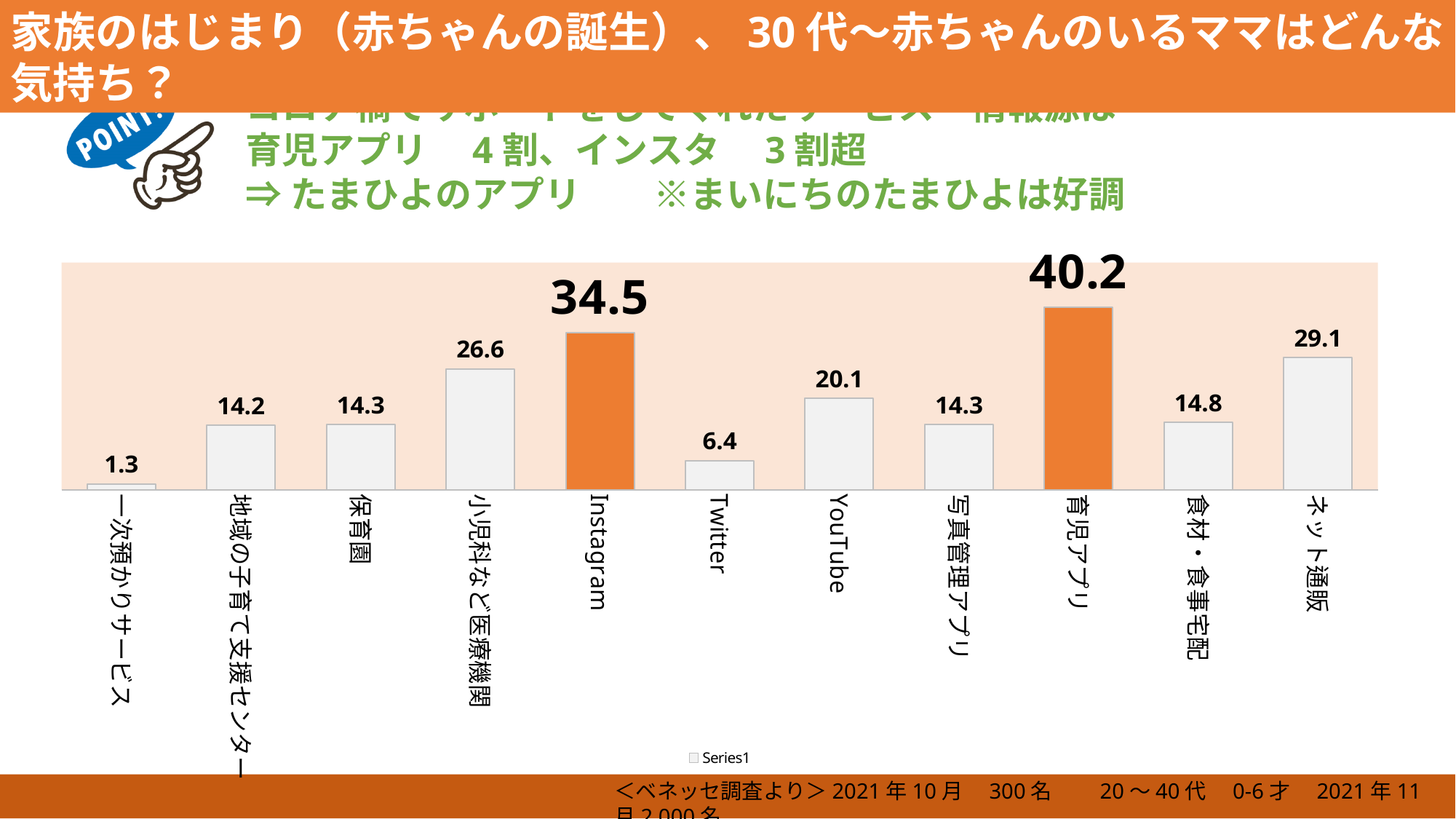
Which two bars are highlighted in orange? Instagram and 育児アプリ Which category has the highest value? 育児アプリ How many categories are shown on the x axis? 11 What is the value for 育児アプリ? 40.2 What is the value for ネット通販? 29.1 How many series does the legend list? 1 What kind of chart is shown? bar chart Which category has the lowest value? 一次預かりサービス What is the value for Instagram? 34.5 Which is larger, the value for YouTube or the value for 小児科など医療機関? 小児科など医療機関 What is the difference between the values for 育児アプリ and Instagram? 5.7 What is the value for Twitter? 6.4